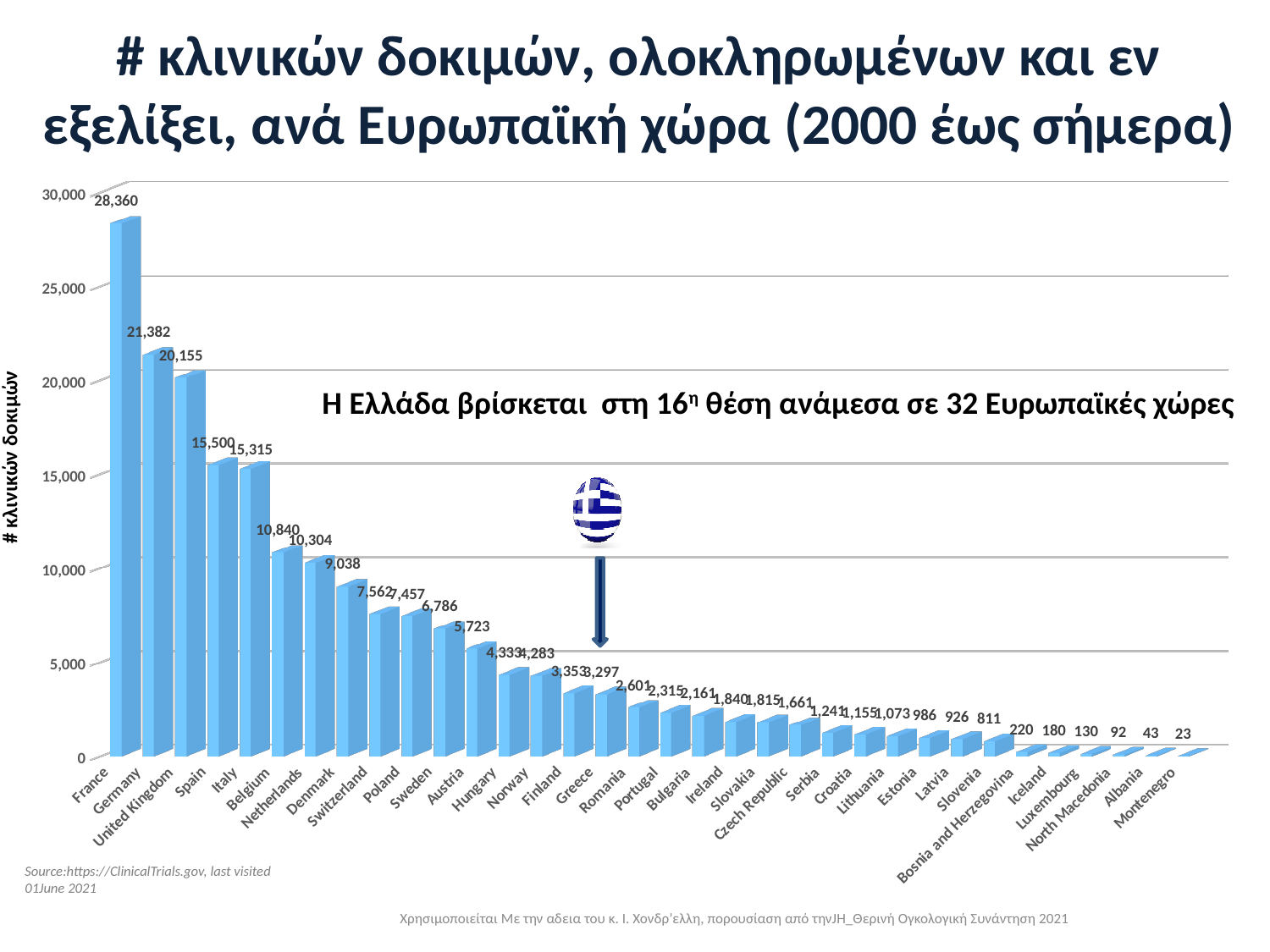
What is the difference between the values for Germany and United Kingdom? 1,227 Do the values rise or fall from left to right along the x axis? fall What is the value for Montenegro? 23 What kind of chart is shown on the slide? bar chart What is the value for Czech Republic? 1,661 According to the text on the slide, in which position does Greece rank among European countries? 16th What is the value for Greece? 3,297 Is the value for Spain greater or less than 15,000? greater Which has a larger value, Belgium or Denmark? Belgium What is the value for France? 28,360 Which country has the lowest number of clinical trials? Montenegro Which country has the highest number of clinical trials? France